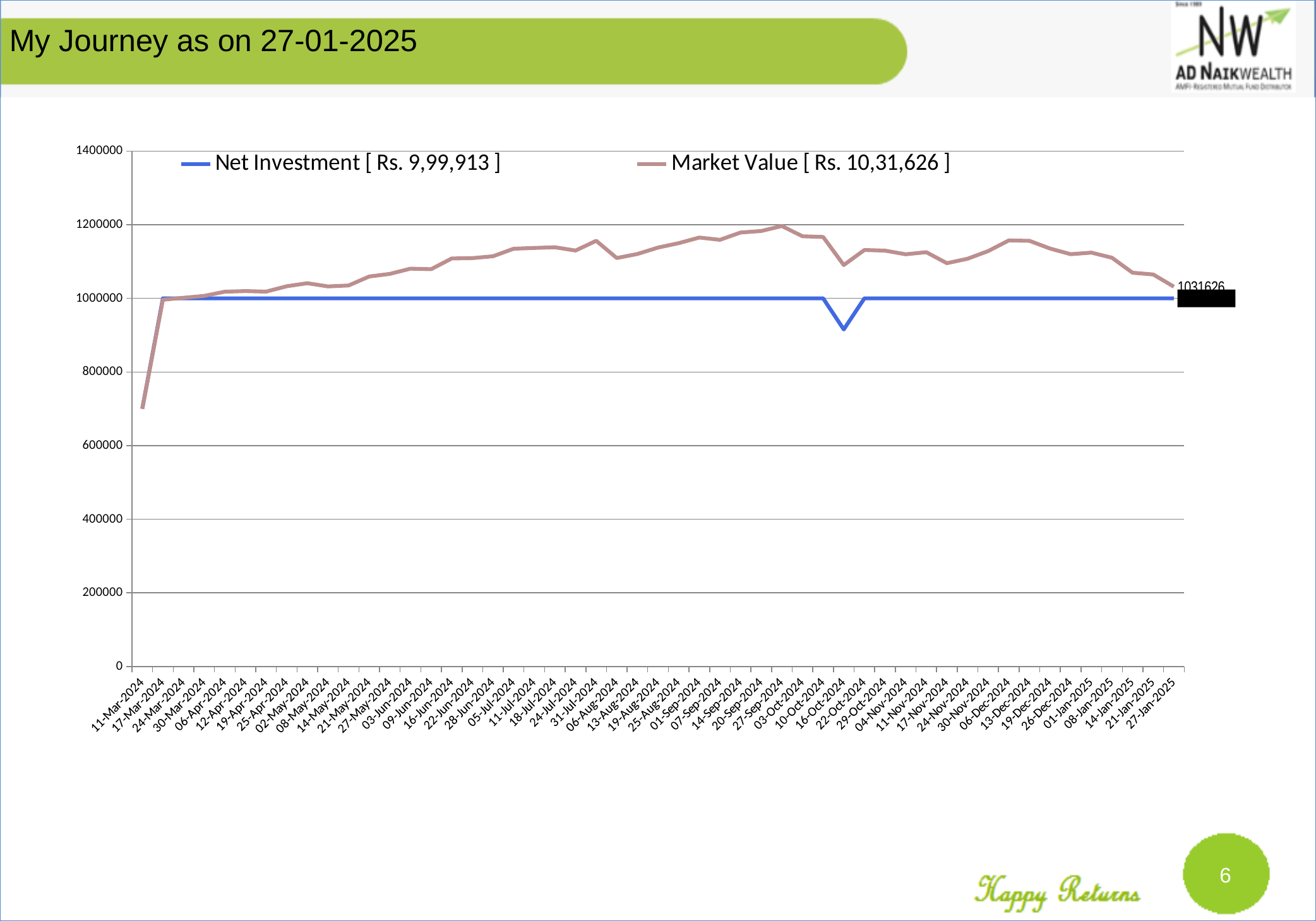
How many series does the chart legend list? 2 What is the Market Value data label shown at the end of the line on 27-Jan-2025? 1031626 Is the Market Value on 27-Sep-2024 greater or less than 1000000? greater On which date is the Market Value line at its lowest? 11-Mar-2024 Is the Market Value on 11-Mar-2024 greater or less than 800000? less What Market Value amount is shown in the legend? Rs. 10,31,626 Is the Net Investment on 16-Oct-2024 greater or less than 1000000? less What Net Investment amount is shown in the legend? Rs. 9,99,913 On 27-Jan-2025, which is higher: Market Value or Net Investment? Market Value On which date does the Market Value line reach its highest point? 27-Sep-2024 What kind of chart is shown on the slide? line chart Does the Market Value line rise or fall between 27-Sep-2024 and 16-Oct-2024? fall